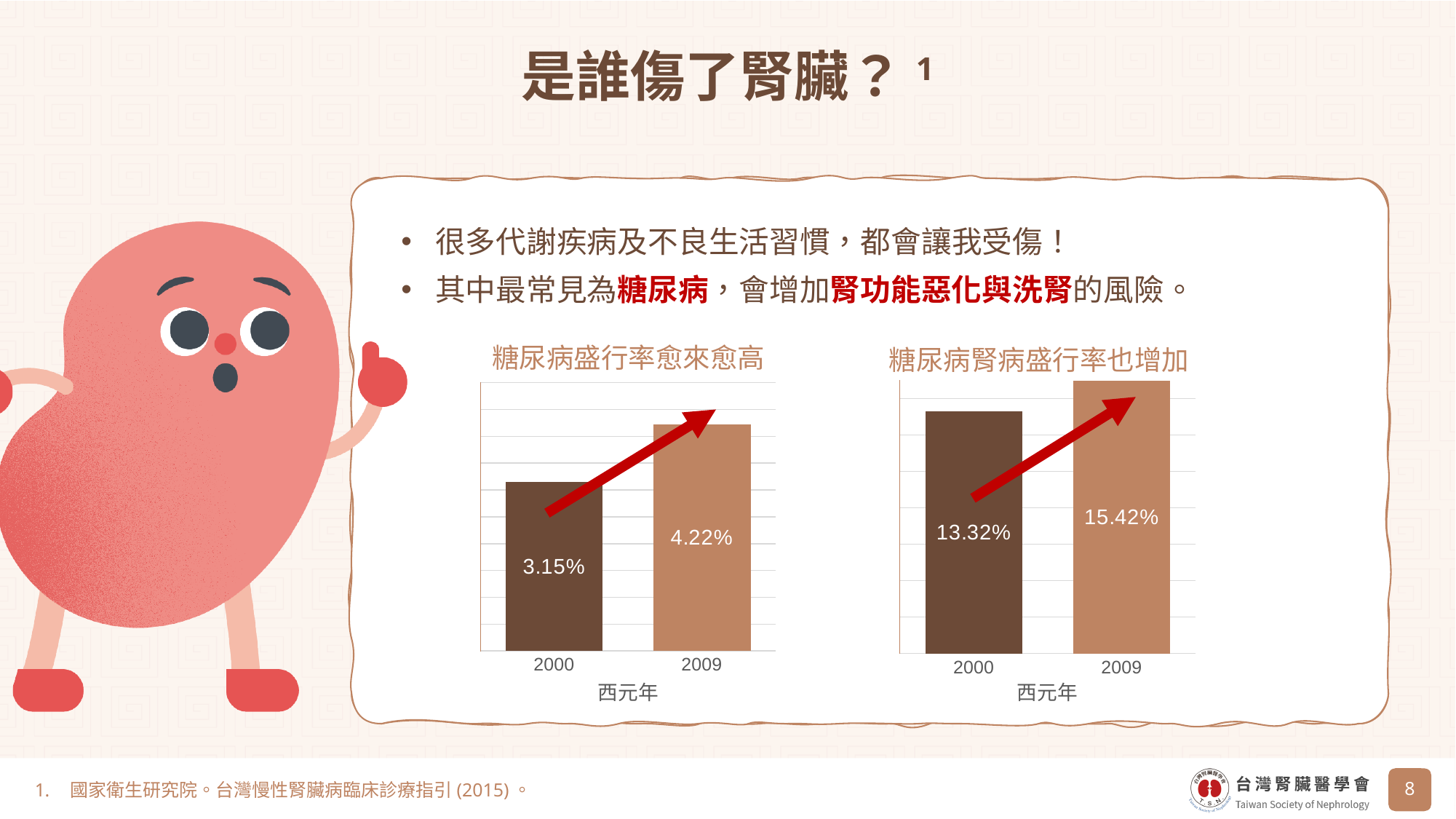
In the right chart (糖尿病腎病盛行率也增加), what is the value for 2009? 15.42% How many bars are shown in the left chart (糖尿病盛行率愈來愈高)? 2 In the left chart (糖尿病盛行率愈來愈高), do the values rise or fall from 2000 to 2009? rise In the left chart (糖尿病盛行率愈來愈高), what is the value for 2009? 4.22% In the right chart (糖尿病腎病盛行率也增加), which year has the lower value? 2000 In the right chart (糖尿病腎病盛行率也增加), is the value for 2009 larger or smaller than the value for 2000? larger In the right chart (糖尿病腎病盛行率也增加), what is the value for 2000? 13.32% What type of chart is the right chart (糖尿病腎病盛行率也增加)? bar chart In the left chart (糖尿病盛行率愈來愈高), what is the value for 2000? 3.15% In the right chart (糖尿病腎病盛行率也增加), what is the difference between the 2009 and 2000 values? 2.10% In the left chart (糖尿病盛行率愈來愈高), what is the difference between the 2009 and 2000 values? 1.07% In the left chart (糖尿病盛行率愈來愈高), which year has the higher value? 2009